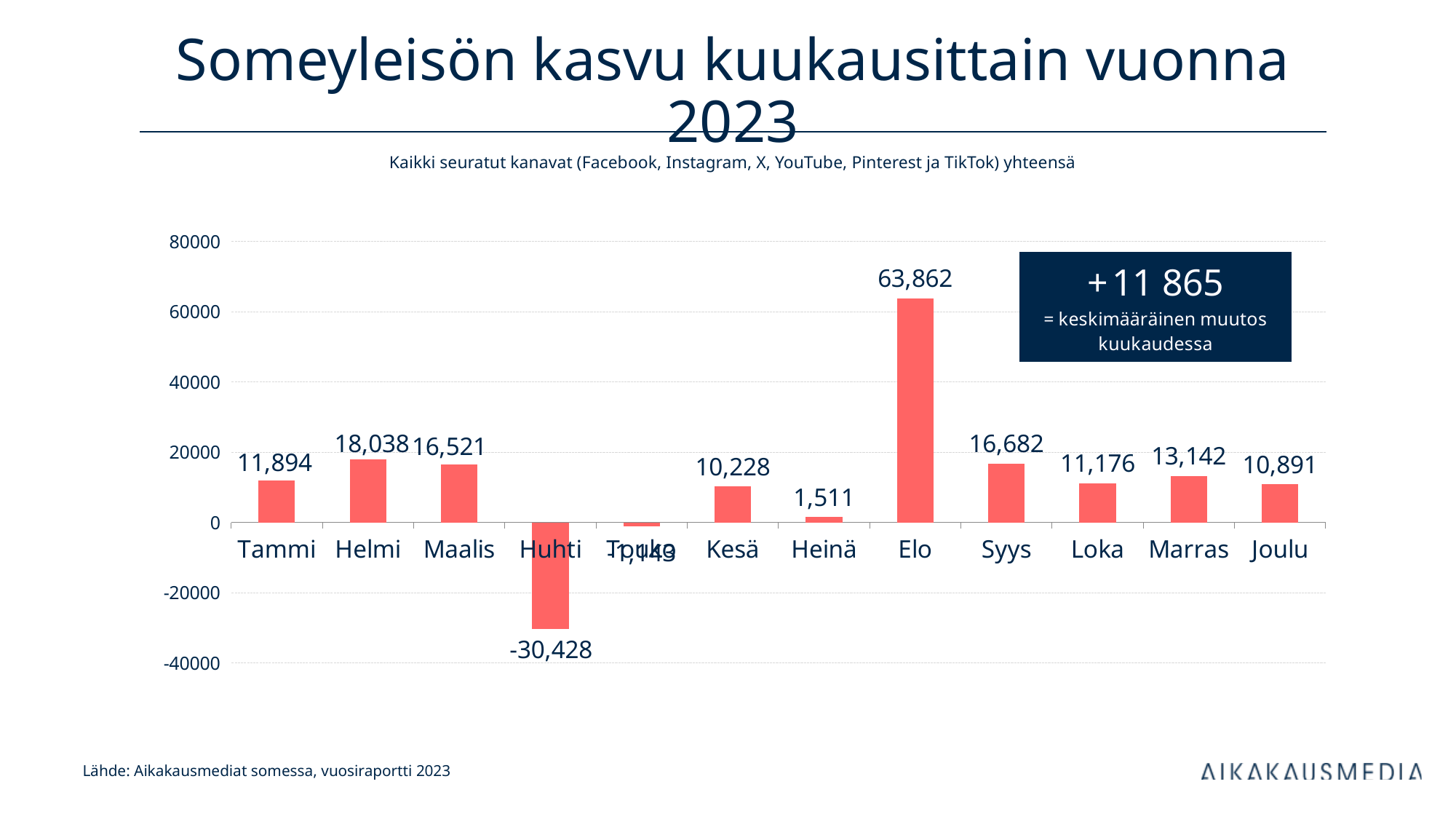
What kind of chart is shown on the slide? bar chart What is the value for Elo? 63,862 How many months are shown on the x axis? 12 Which month has the highest value? Elo Is the value for Elo greater or less than 60000? greater Which month has the lowest value? Huhti What is the value for Marras? 13,142 What is the value for Huhti? -30,428 What is the value for Heinä? 1,511 Which is larger, the value for Syys or the value for Loka? Syys What is the difference between the values for Elo and Syys? 47,180 What is the difference between the values for Helmi and Maalis? 1,517